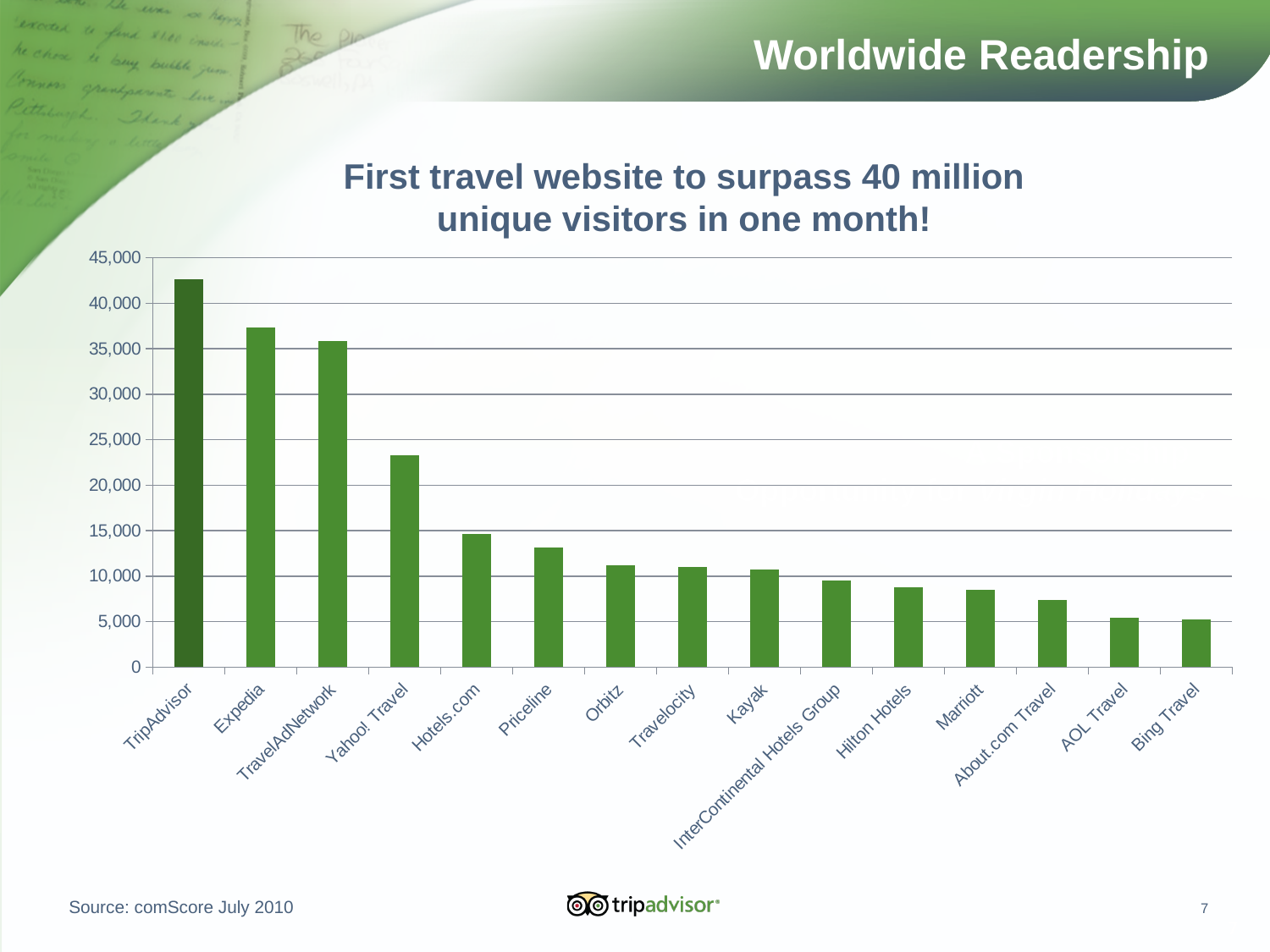
Is the value for TripAdvisor greater or less than 40,000? greater Is the value for Yahoo! Travel greater or less than 20,000? greater Which bar in the chart is shown in a darker green than the others? TripAdvisor Which has a larger value, Yahoo! Travel or Hotels.com? Yahoo! Travel Which website has the highest value in the chart? TripAdvisor How many travel websites are shown on the x axis of the chart? 15 Is the value for Priceline greater or less than 10,000? greater Do the values rise or fall moving from left to right along the x axis? fall What kind of chart is shown on the slide? bar chart